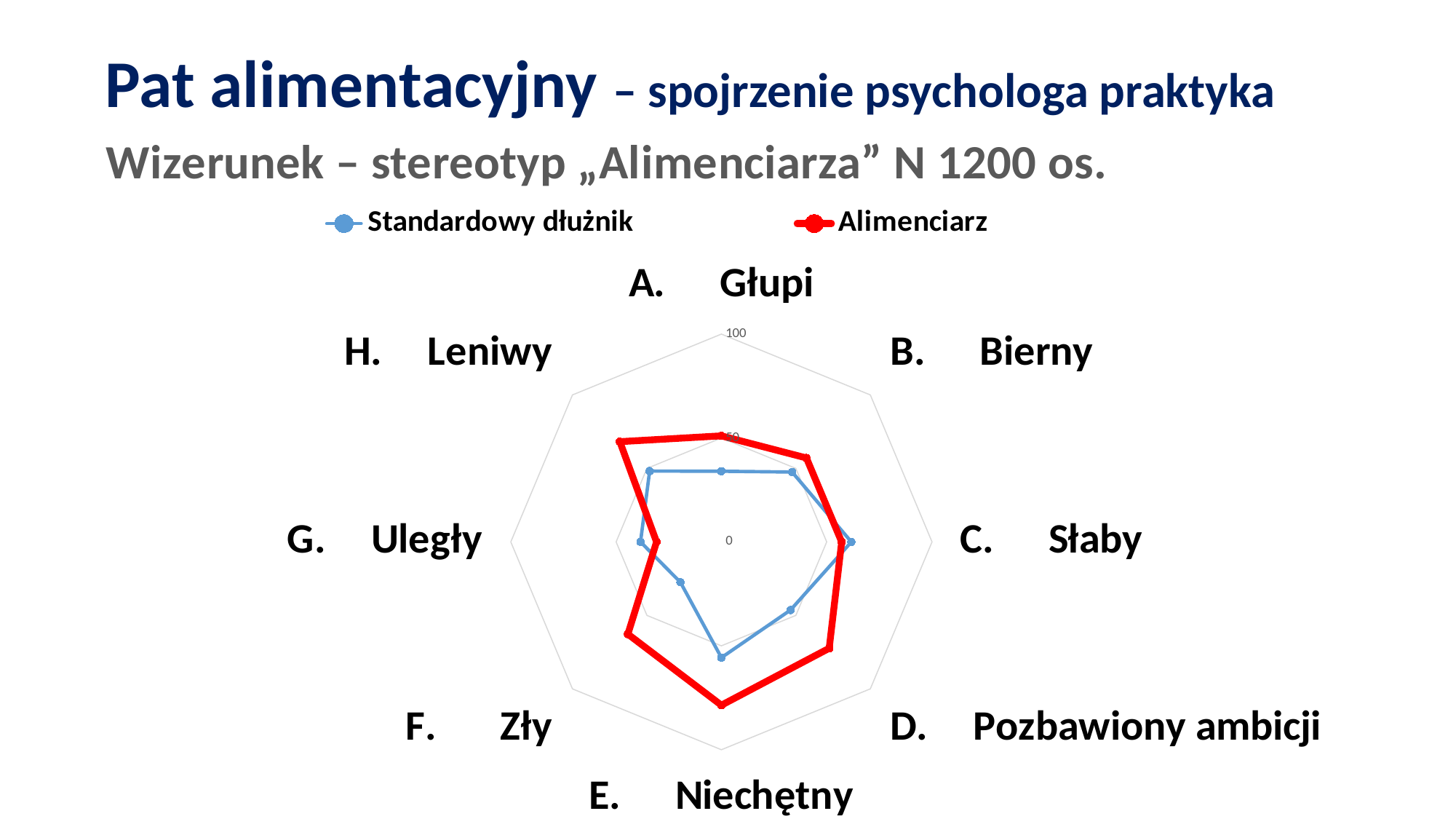
For which category does the Standardowy dłużnik series have its lowest value? F. Zły What kind of chart is shown on the slide? Radar chart Is the Alimenciarz value for G. Uległy greater or less than 50? less How many series does the legend list? 2 Is the Standardowy dłużnik value for F. Zły greater or less than 50? less For E. Niechętny, which series has the larger value, Standardowy dłużnik or Alimenciarz? Alimenciarz For which category does the Alimenciarz series have its lowest value? G. Uległy For which category does the Alimenciarz series reach its highest value? E. Niechętny Is the Alimenciarz value for E. Niechętny greater or less than 50? greater For G. Uległy, which series has the larger value, Standardowy dłużnik or Alimenciarz? Standardowy dłużnik Which series is drawn in red? Alimenciarz How many categories (axes) does the radar chart have? 8